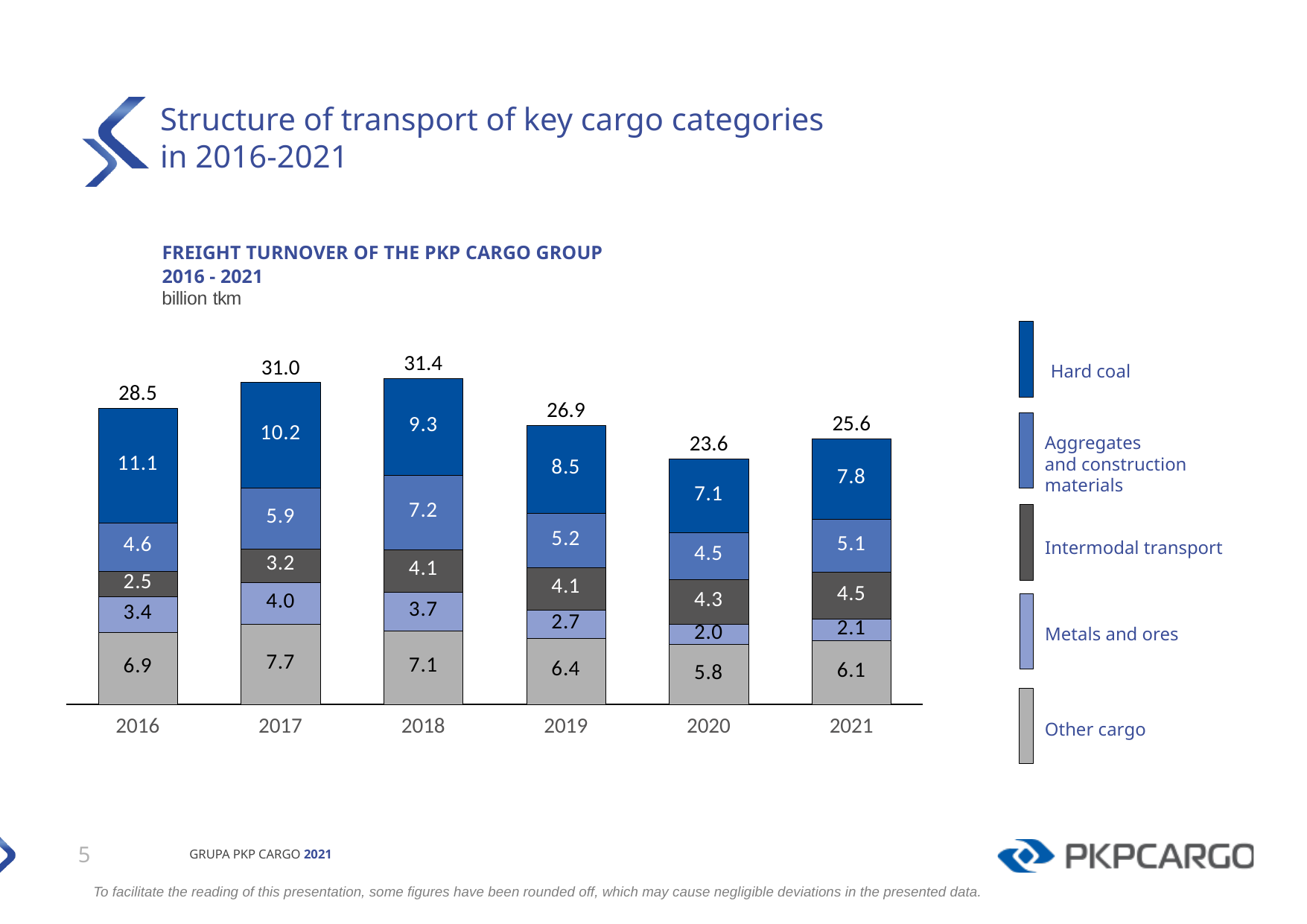
What was the Metals and ores value in 2018? 3.7 Which year had the highest total freight turnover? 2018 What was the Intermodal transport value in 2020? 4.3 How many years are shown on the x axis? 6 What was the Hard coal freight turnover in 2016? 11.1 Which is larger, the Other cargo value in 2017 or in 2021? 2017 How many cargo categories does the legend list? 5 What is the difference between the Hard coal values in 2016 and 2021? 3.3 Did the Hard coal value rise or fall from 2016 to 2020? Fall What kind of chart is shown on the slide? Stacked bar chart Which year had the lowest total freight turnover? 2020 What is the total freight turnover for 2019? 26.9